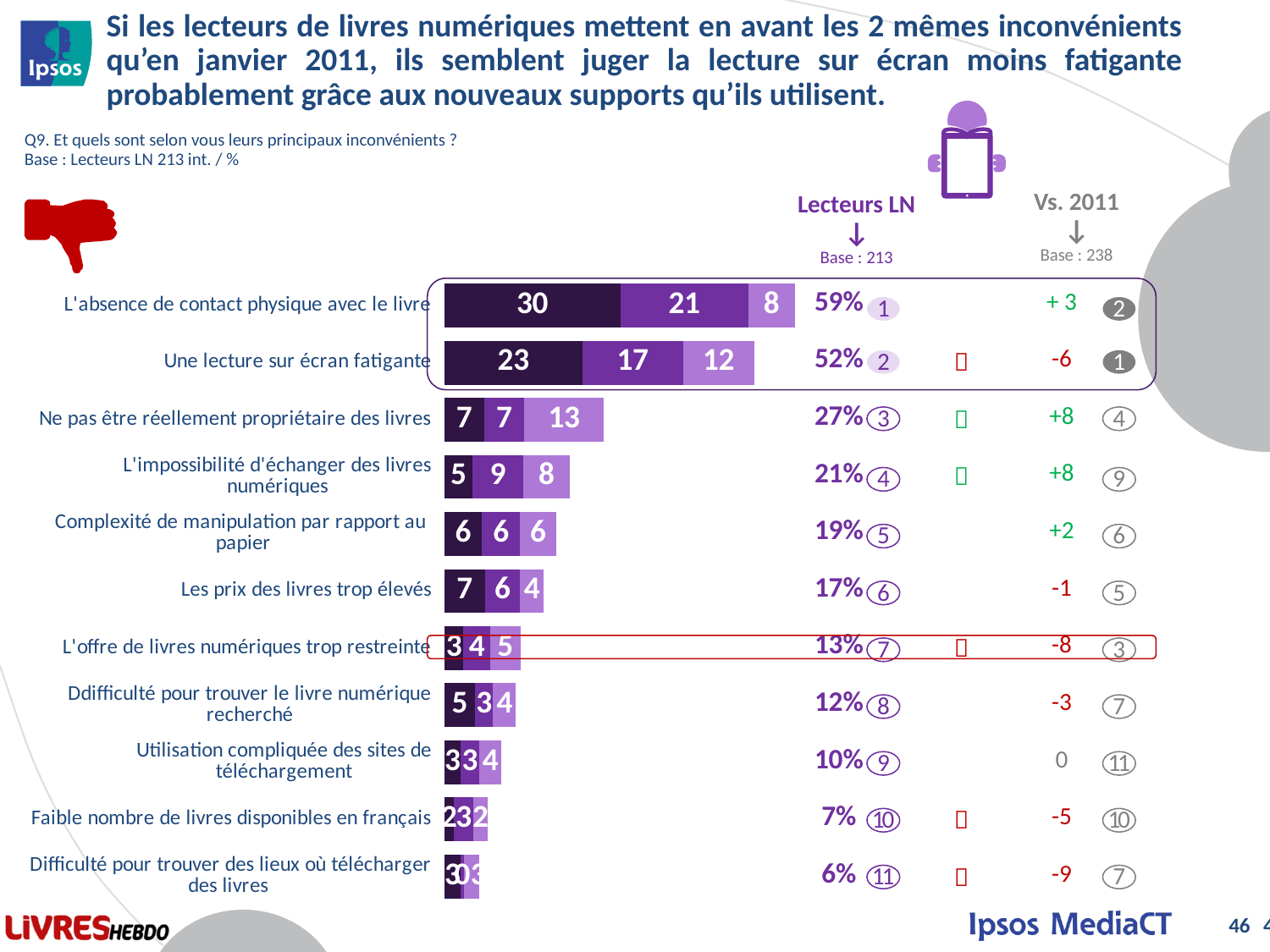
What is the "Vs. 2011" change shown for "Ne pas être réellement propriétaire des livres"? +8 Which category has the lowest total percentage? Difficulté pour trouver des lieux où télécharger des livres How many inconvenient categories are plotted in the chart? 11 Do the total percentages increase or decrease going from the top category to the bottom category? decrease What kind of chart is used to show the inconvenients of digital books on this slide? bar chart What is the value of the first (darkest) segment of the bar for "Une lecture sur écran fatigante"? 23 What is the total percentage shown for "L'absence de contact physique avec le livre"? 59% What is the difference in total percentage between "L'absence de contact physique avec le livre" and "Une lecture sur écran fatigante"? 7 percentage points What is the base (number of respondents) indicated for the "Lecteurs LN" column? 213 Which has a higher total percentage: "Ne pas être réellement propriétaire des livres" or "Les prix des livres trop élevés"? Ne pas être réellement propriétaire des livres Which category has the highest total percentage? L'absence de contact physique avec le livre What is the value of the lightest (third) segment of the bar for "Ne pas être réellement propriétaire des livres"? 13